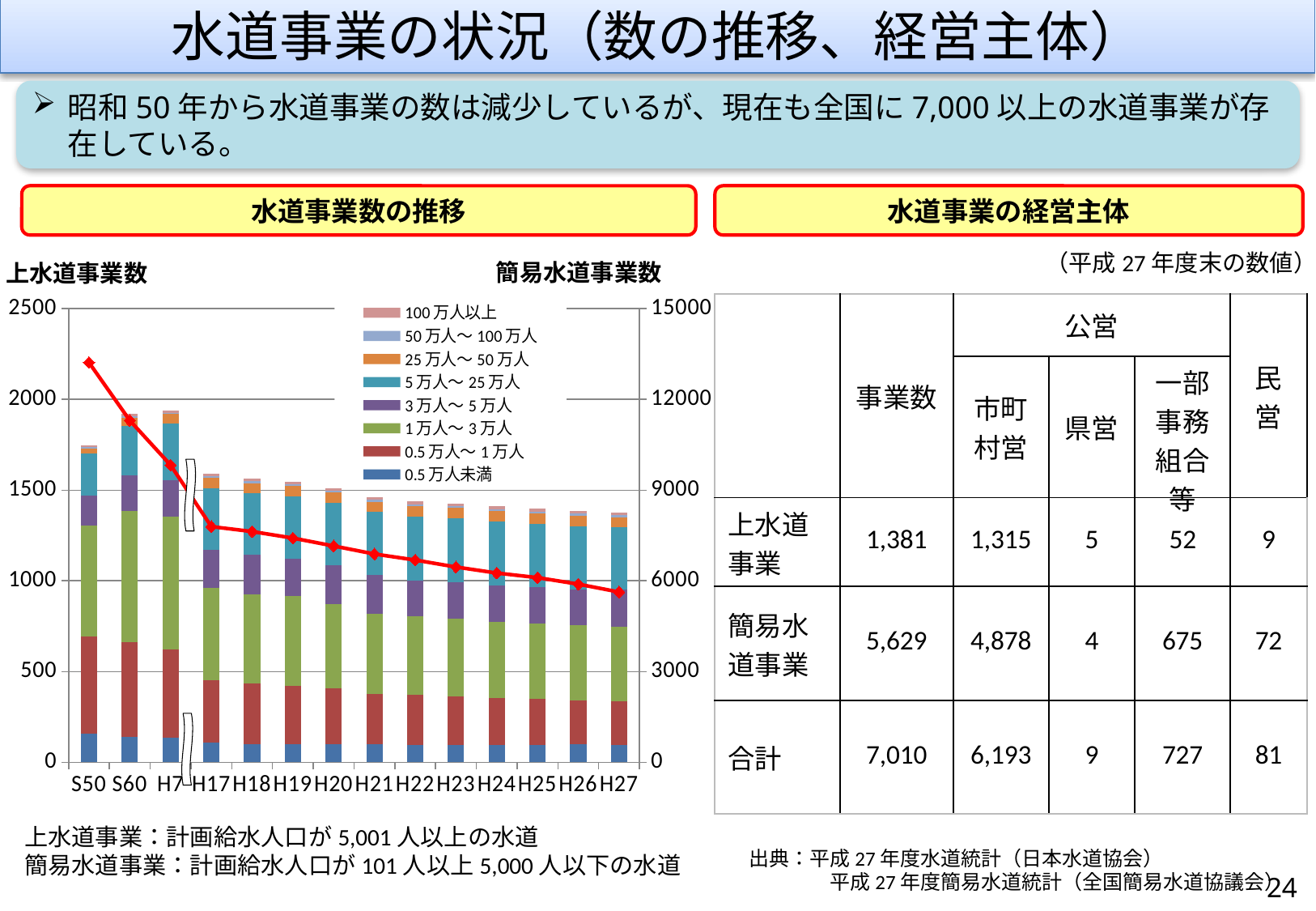
Does the red line (簡易水道事業数) rise or fall from S50 to H27? Fall What kind of chart is shown under the heading 水道事業数の推移? A stacked bar chart combined with a line At which year does the red line reach its highest value? S50 Which is larger, the total stacked bar for S50 or for H27? S50 Is the total height of the stacked bar for H7 greater or less than 1500 on the left axis? greater What is the label of the left vertical axis of the chart? 上水道事業数 Is the value of the red line at H27 greater or less than 6000 on the right axis? less How many year categories are shown on the x axis of the chart? 14 How many series does the chart's legend list? 8 What is the maximum tick value shown on the right vertical axis of the chart? 15000 Is the value of the red line at S50 greater or less than 12000 on the right axis? greater